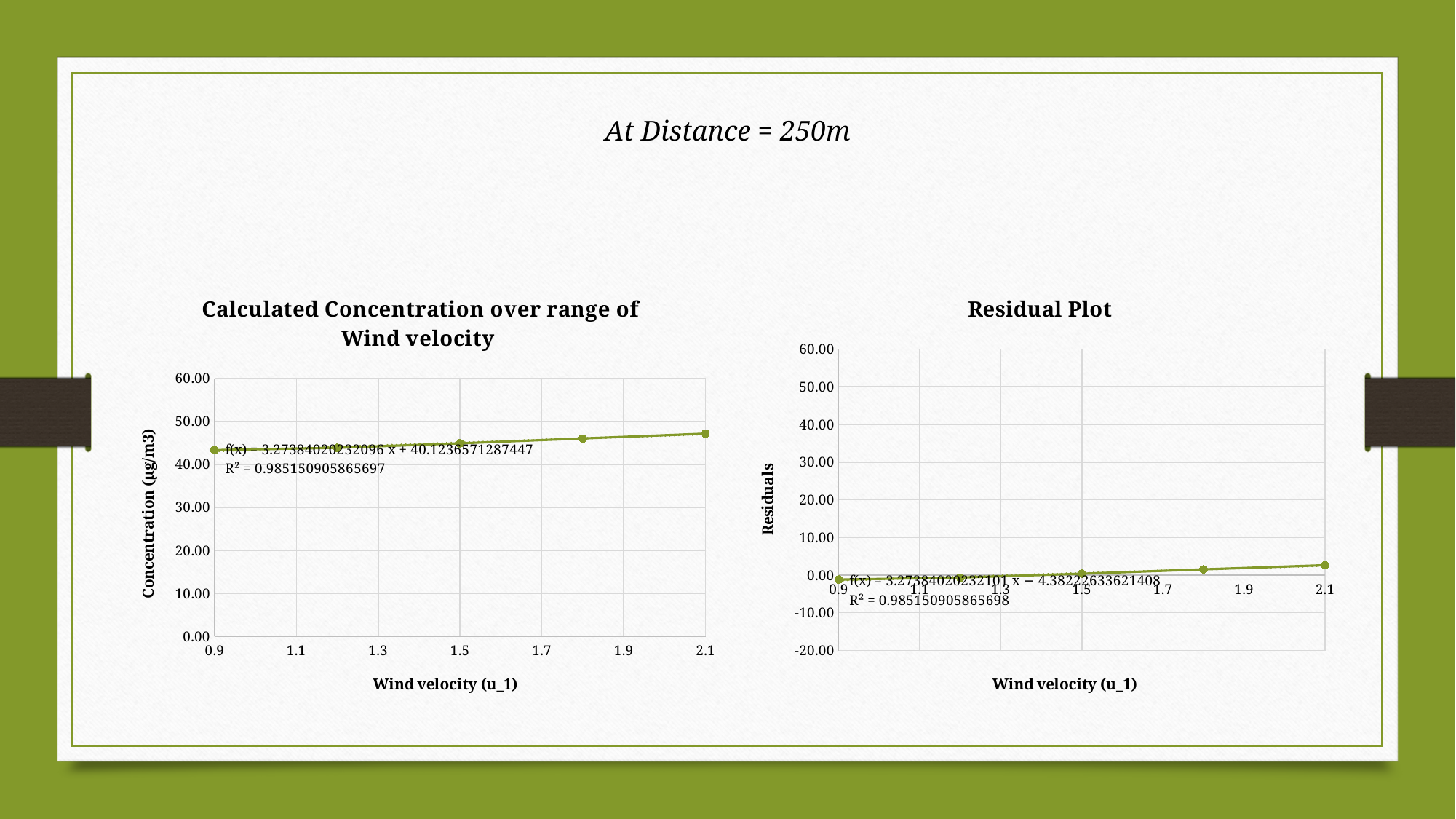
In the 'Residual Plot' chart, is the residual at wind velocity 2.1 greater or less than 10.00? less What is the y-axis label of the 'Calculated Concentration over range of Wind velocity' chart? Concentration (µg/m3) What kind of chart is the 'Calculated Concentration over range of Wind velocity' chart? scatter chart with a line In the 'Residual Plot' chart, do the residuals rise or fall as wind velocity increases? rise How many data points are plotted in the 'Residual Plot' chart? 5 How many data points are plotted in the 'Calculated Concentration over range of Wind velocity' chart? 5 In the 'Residual Plot' chart, which is larger: the residual at wind velocity 0.9 or at 2.1? 2.1 In the 'Calculated Concentration over range of Wind velocity' chart, do the values rise or fall as wind velocity increases? rise In the 'Calculated Concentration over range of Wind velocity' chart, is the value at wind velocity 0.9 greater or less than 50.00? less In the 'Calculated Concentration over range of Wind velocity' chart, at which wind velocity is the concentration highest? 2.1 In the 'Calculated Concentration over range of Wind velocity' chart, at which wind velocity is the concentration lowest? 0.9 In the 'Calculated Concentration over range of Wind velocity' chart, is the value at wind velocity 2.1 greater or less than 40.00? greater